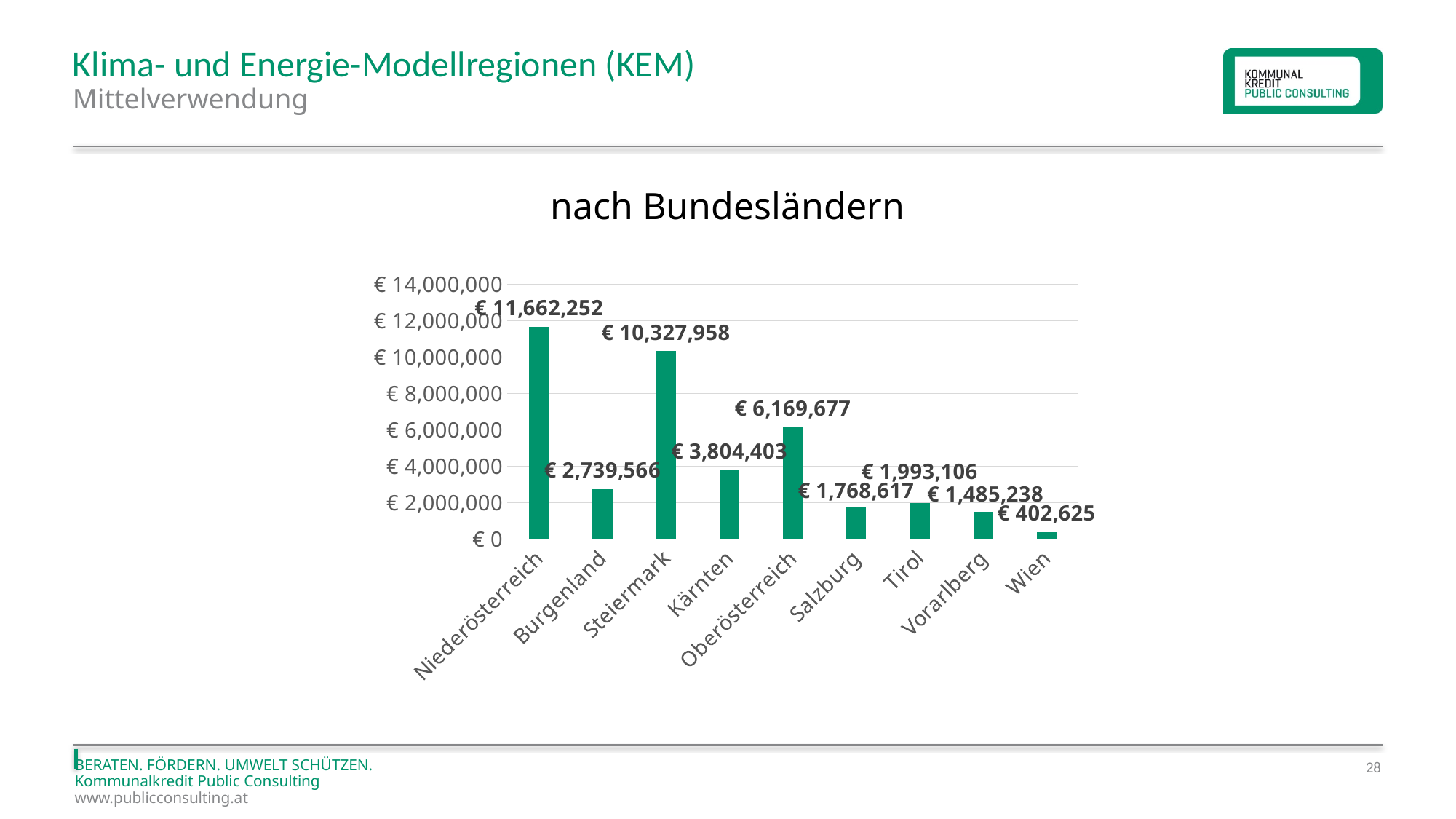
What is the value for Wien? € 402,625 What type of chart is shown on the slide? Bar chart Which Bundesland has the highest value? Niederösterreich How many Bundesländer are shown on the x axis? 9 What is the value for Oberösterreich? € 6,169,677 What is the title of the chart? nach Bundesländern What is the difference between the values for Niederösterreich and Steiermark? € 1,334,294 What is the value for Vorarlberg? € 1,485,238 Which has a larger value, Tirol or Salzburg? Tirol What is the value for Niederösterreich? € 11,662,252 Which Bundesland has the lowest value? Wien What is the difference between the values for Oberösterreich and Kärnten? € 2,365,274